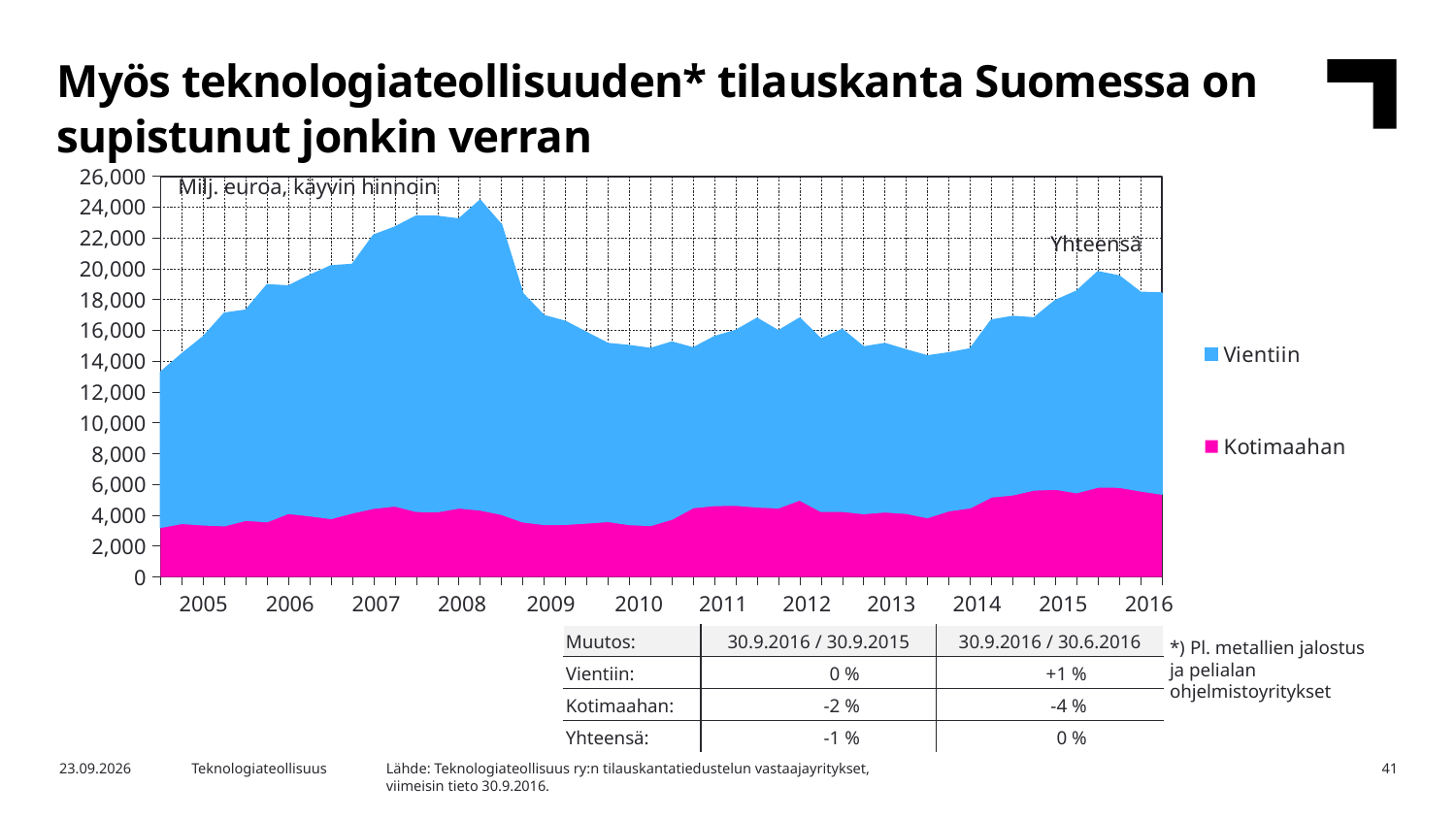
How many year labels are shown on the x axis of the chart? 12 What are the two series named in the chart legend? Vientiin and Kotimaahan Is the total (Yhteensä) at its 2008 peak greater or less than 22,000? greater How many series does the chart legend list? 2 Does the Kotimaahan series rise or fall between 2013 and 2015? rise Which series is larger throughout the chart, Vientiin or Kotimaahan? Vientiin Does the total (Yhteensä) rise or fall between 2008 and 2009? fall In the table below the chart, what is the change (Muutos) for Kotimaahan for 30.9.2016 / 30.6.2016? -4 % Is the total (Yhteensä) value in 2016 greater or less than 16,000? greater What kind of chart is shown on the slide? Stacked area chart Is the Kotimaahan value in 2005 greater or less than 4,000? less What unit label is shown at the top of the chart? Milj. euroa, käyvin hinnoin